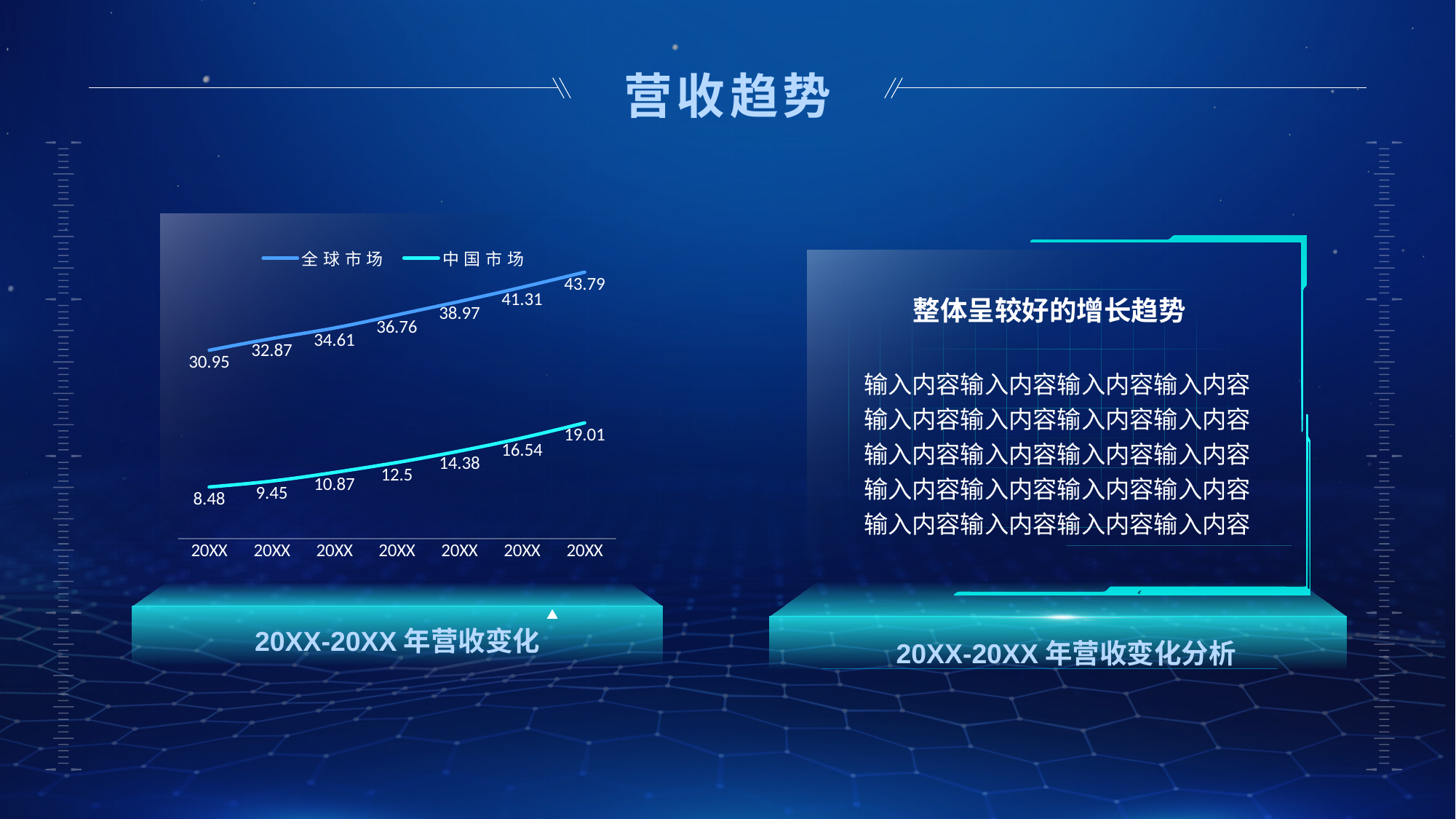
Do the values of the 中国市场 line rise or fall from left to right? rise Which series has the higher value at the rightmost point, 全球市场 or 中国市场? 全球市场 How many series does the chart legend list? 2 What is the lowest value on the 中国市场 line? 8.48 What is the highest value on the 全球市场 line? 43.79 At the last (rightmost) point, what is the difference between the 全球市场 value and the 中国市场 value? 24.78 How many data points does each line in the chart have? 7 What is the value of the first (leftmost) point of the 全球市场 line? 30.95 What is the value of the fourth point of the 中国市场 line? 12.5 What is the value of the last (rightmost) point of the 中国市场 line? 19.01 At the first (leftmost) point, what is the difference between the 全球市场 value and the 中国市场 value? 22.47 What kind of chart is shown on the slide? line chart